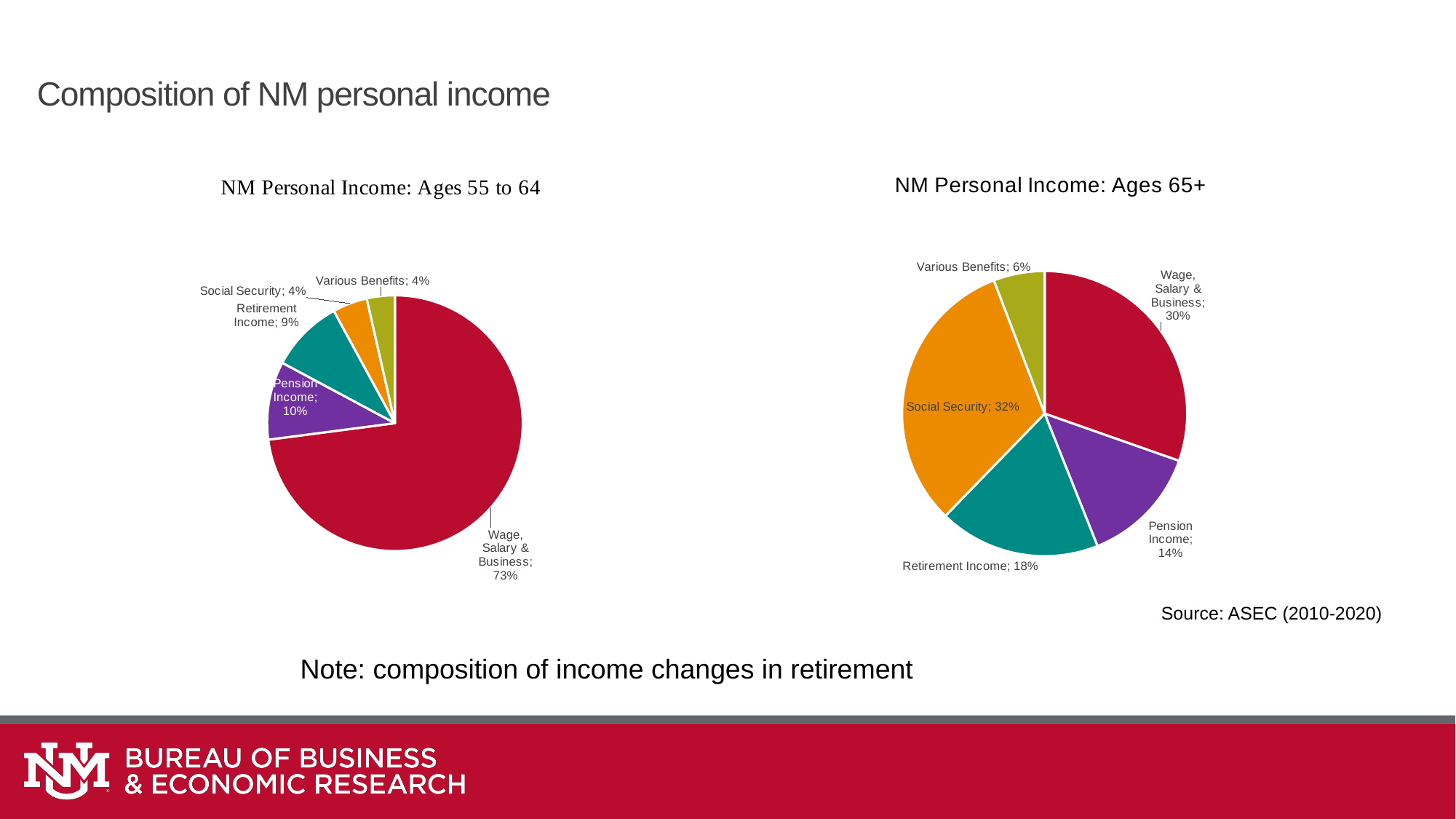
How many categories are shown in the 'NM Personal Income: Ages 65+' chart? 5 In the 'NM Personal Income: Ages 55 to 64' chart, what share does Wage, Salary & Business have? 73% What is the title of the chart on the right side of the slide? NM Personal Income: Ages 65+ In the 'NM Personal Income: Ages 65+' chart, which category has the smallest share? Various Benefits In the 'NM Personal Income: Ages 55 to 64' chart, which is larger, Retirement Income or Social Security? Retirement Income What kind of chart is 'NM Personal Income: Ages 55 to 64'? Pie chart In the 'NM Personal Income: Ages 55 to 64' chart, what is the value for Pension Income? 10% In the 'NM Personal Income: Ages 65+' chart, which category has the largest share? Social Security In the 'NM Personal Income: Ages 65+' chart, what is the difference between the Social Security share and the Pension Income share? 18% In the 'NM Personal Income: Ages 65+' chart, what is the value for Retirement Income? 18% In the 'NM Personal Income: Ages 65+' chart, what share does Social Security have? 32% In the 'NM Personal Income: Ages 55 to 64' chart, which category has the largest share? Wage, Salary & Business